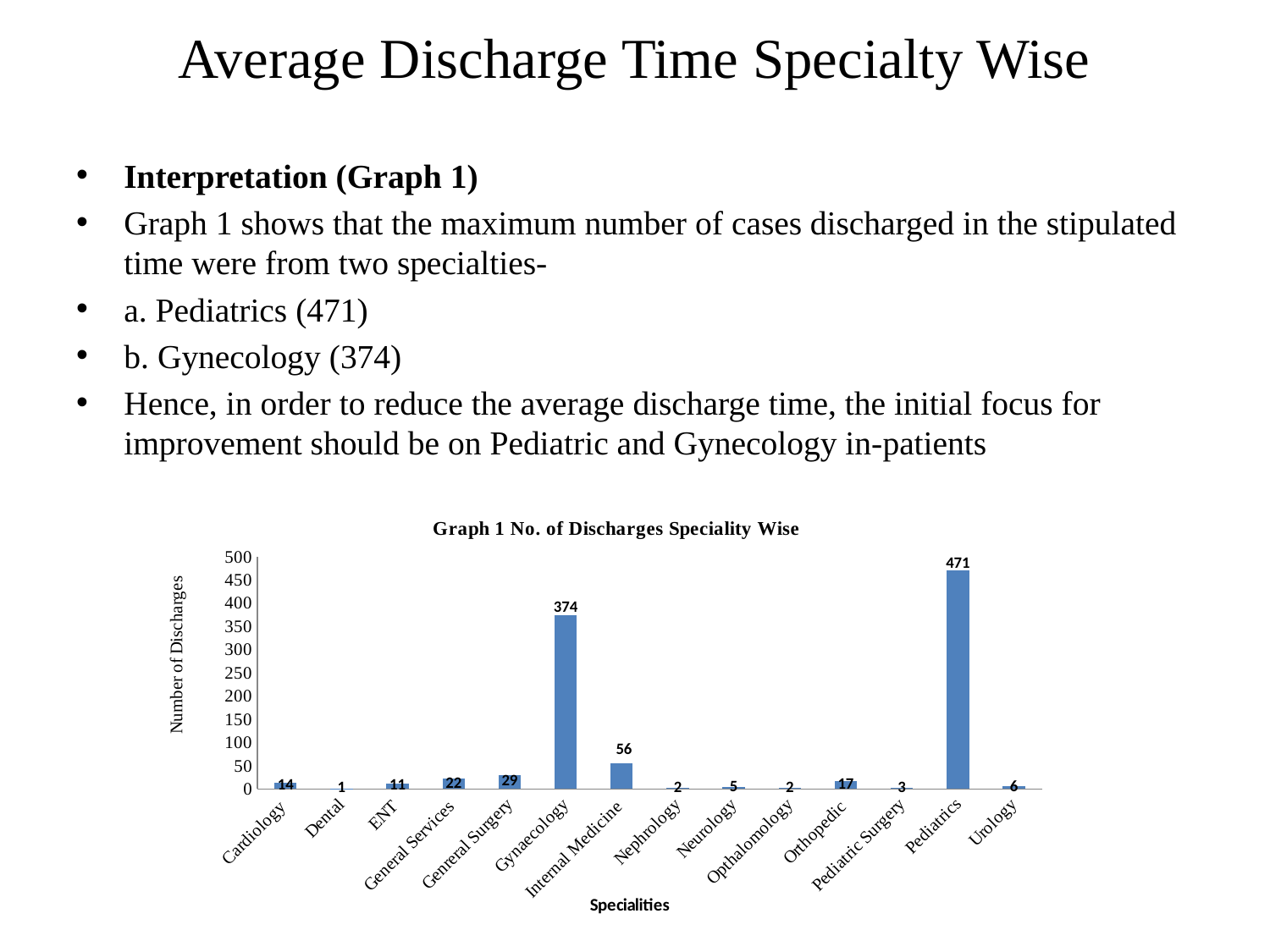
What is the title of the chart? Graph 1 No. of Discharges Speciality Wise What is the difference in discharges between Pediatrics and Gynaecology? 97 Which speciality has the lowest number of discharges? Dental Is the value for Pediatrics greater or less than 450? greater What kind of chart is shown on the slide? Bar chart What is the number of discharges for Gynaecology? 374 What is the number of discharges for Internal Medicine? 56 What is the number of discharges for General Surgery? 29 What is the label of the y axis? Number of Discharges Which has more discharges, Cardiology or Orthopedic? Orthopedic How many specialities are shown on the x axis? 14 Which speciality has the highest number of discharges? Pediatrics